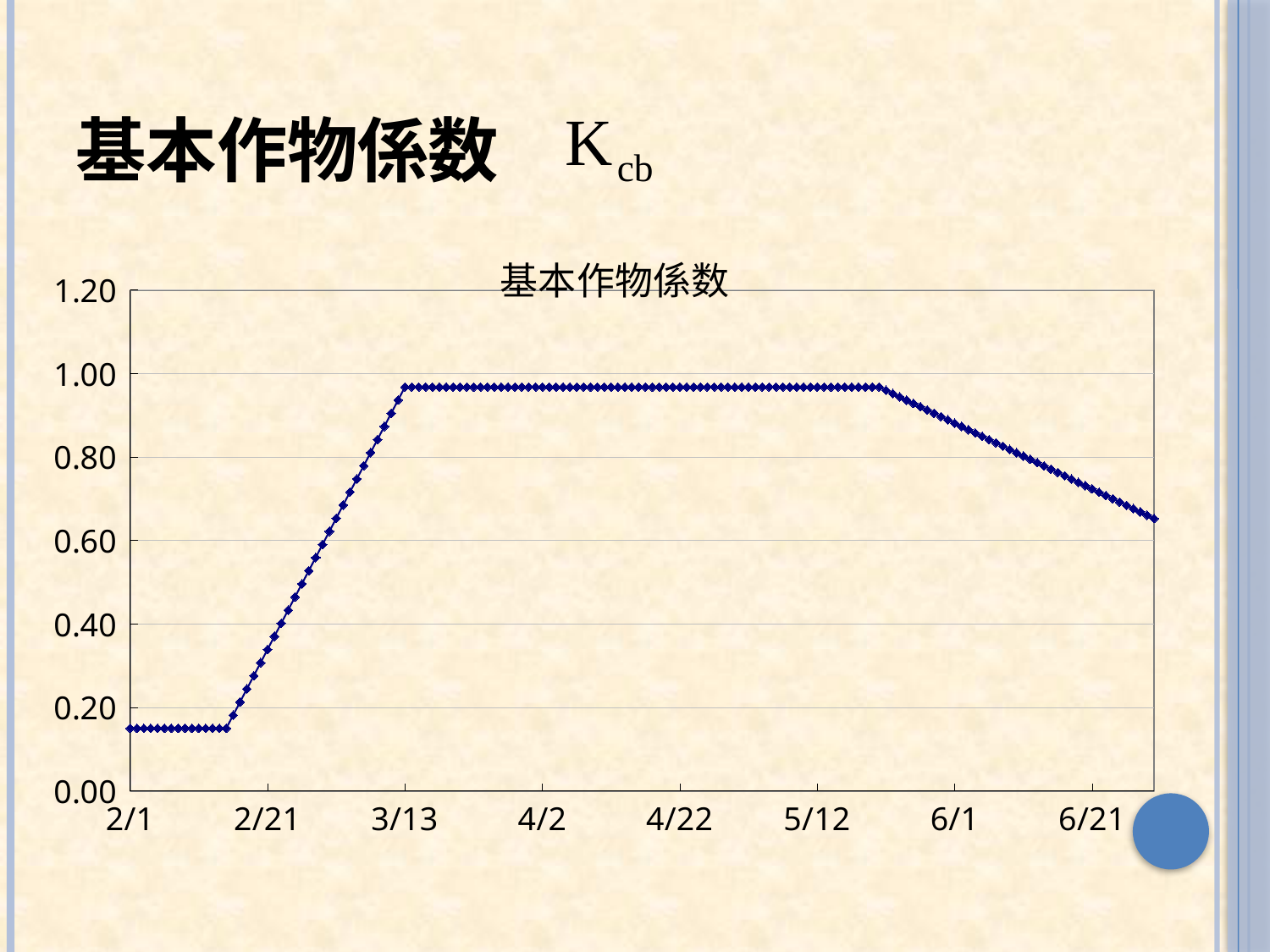
Does the line rise or fall between 2/21 and 3/13? rise Is the value on 2/21 greater or less than 0.20? greater What kind of chart is shown on the slide? line chart Is the value on 6/21 greater or less than 0.60? greater Is the value on 4/2 greater or less than 0.80? greater Does the line rise or fall between 6/1 and 6/21? fall How many date labels are shown on the x axis? 8 Does the line rise, fall, or stay flat between 4/2 and 5/12? stay flat What is the highest value shown on the y axis? 1.20 What is the title of the chart? 基本作物係数